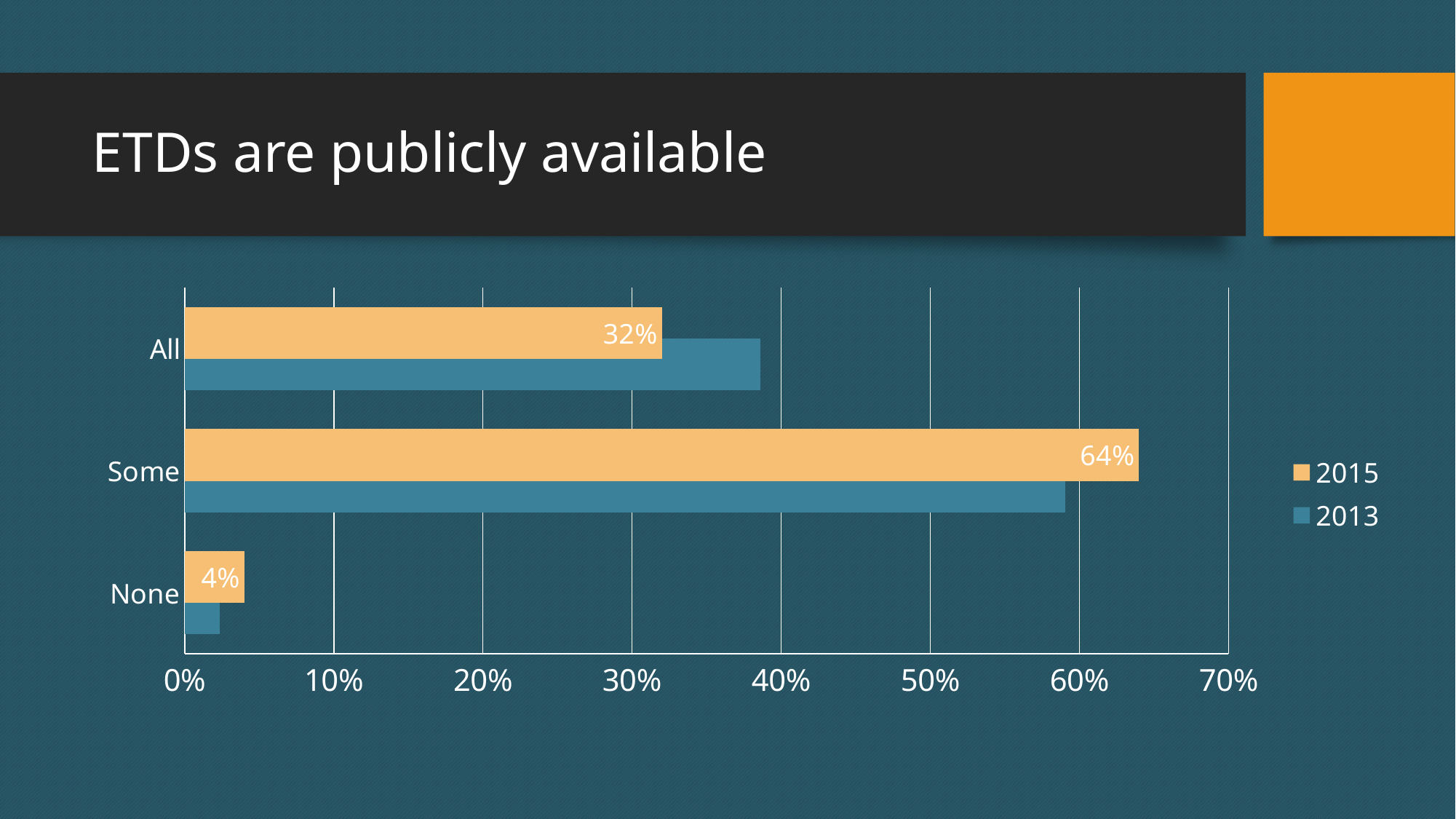
Is the 2013 value for Some greater or less than 50%? greater Which category has the highest 2015 value? Some Which category has the lowest 2015 value? None What is the 2015 value for All? 32% What is the 2015 value for Some? 64% What is the 2015 value for None? 4% Is the 2013 value for All greater or less than 40%? less For the All category, which series has the larger value, 2015 or 2013? 2013 How many categories are shown on the chart? 3 How many series does the legend list? 2 What is the difference between the 2015 values for Some and All? 32% For the Some category, which series has the larger value, 2015 or 2013? 2015